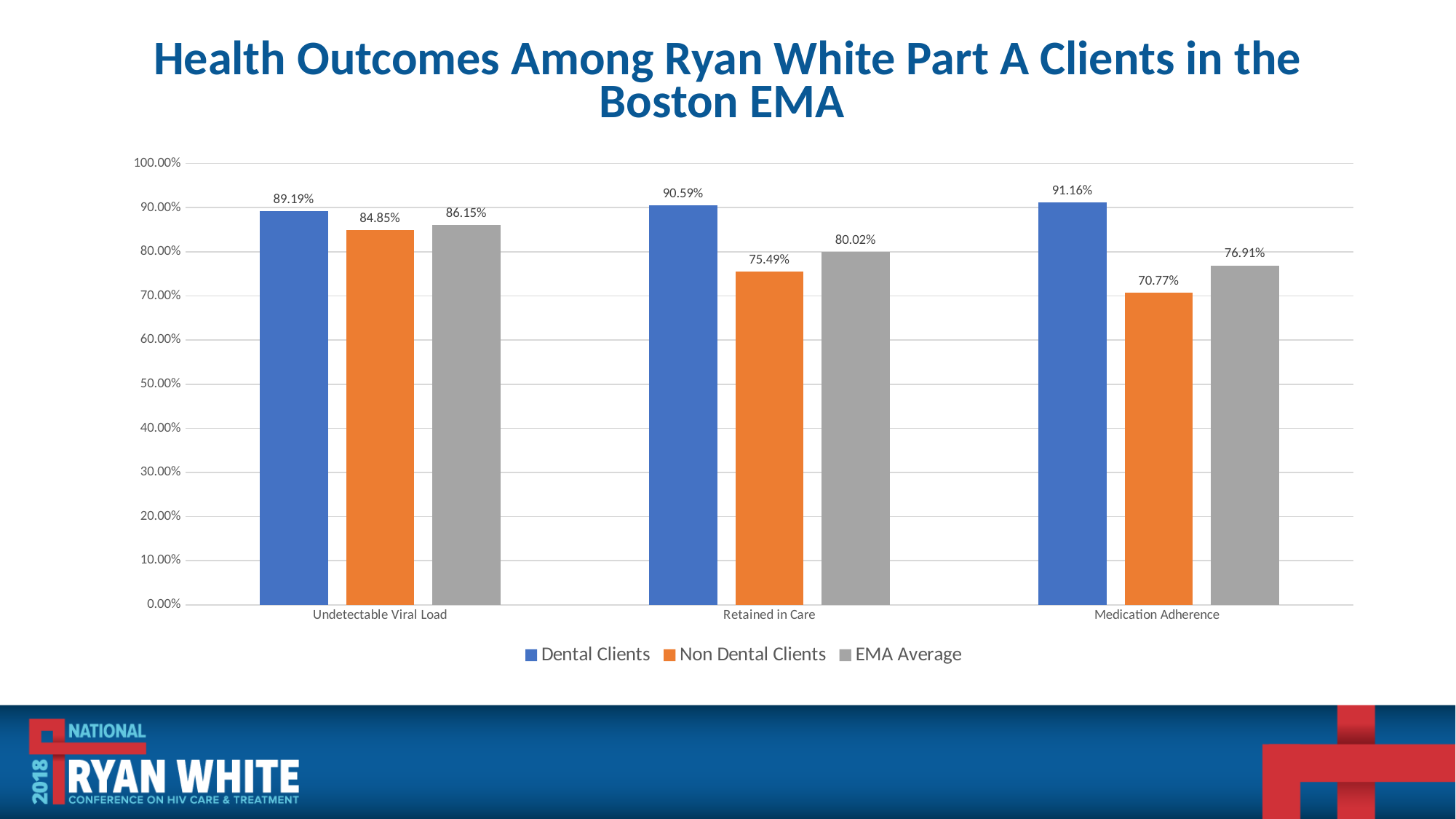
How many series does the legend list? 3 Which series is shown in orange in the legend? Non Dental Clients What kind of chart is shown on the slide? Bar chart Which category has the lowest value for Non Dental Clients? Medication Adherence What is the value for Non Dental Clients in the Retained in Care category? 75.49% What is the value for Dental Clients in the Undetectable Viral Load category? 89.19% What is the difference between the Dental Clients and Non Dental Clients values for Medication Adherence? 20.39% Is the value for Non Dental Clients in the Undetectable Viral Load category greater or less than 80.00%? greater What is the EMA Average value for Medication Adherence? 76.91% Which category has the highest value for Dental Clients? Medication Adherence How many categories are shown on the x axis? 3 Which is larger for Retained in Care: the Non Dental Clients value or the EMA Average value? EMA Average